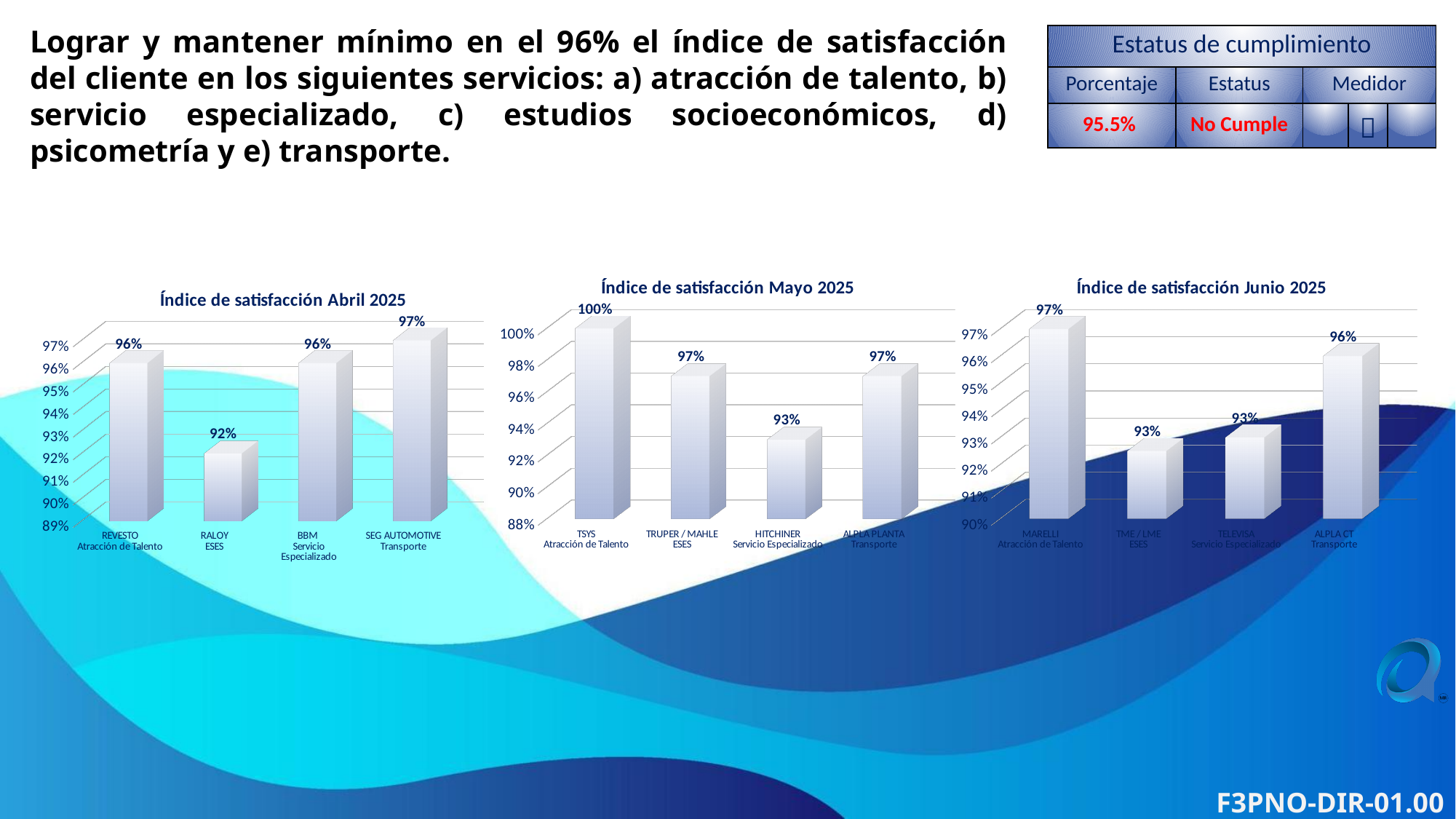
In the 'Índice de satisfacción Junio 2025' chart, what is the value for ALPLA CT? 96% In the 'Índice de satisfacción Junio 2025' chart, which category has the highest value? MARELLI In the 'Índice de satisfacción Abril 2025' chart, which category has the highest value? SEG AUTOMOTIVE What kind of chart is 'Índice de satisfacción Abril 2025'? Bar chart In the 'Índice de satisfacción Mayo 2025' chart, how many categories are plotted? 4 In the 'Índice de satisfacción Mayo 2025' chart, what is the value for TSYS? 100% In the 'Índice de satisfacción Mayo 2025' chart, what is the difference between TSYS and HITCHINER? 7% In the 'Índice de satisfacción Mayo 2025' chart, which category has the lowest value? HITCHINER In the 'Índice de satisfacción Abril 2025' chart, what is the value for RALOY? 92% In the 'Índice de satisfacción Abril 2025' chart, what is the difference between SEG AUTOMOTIVE and RALOY? 5% In the 'Índice de satisfacción Junio 2025' chart, which is larger, MARELLI or TME / LME? MARELLI In the 'Índice de satisfacción Abril 2025' chart, what is the value for BBM? 96%